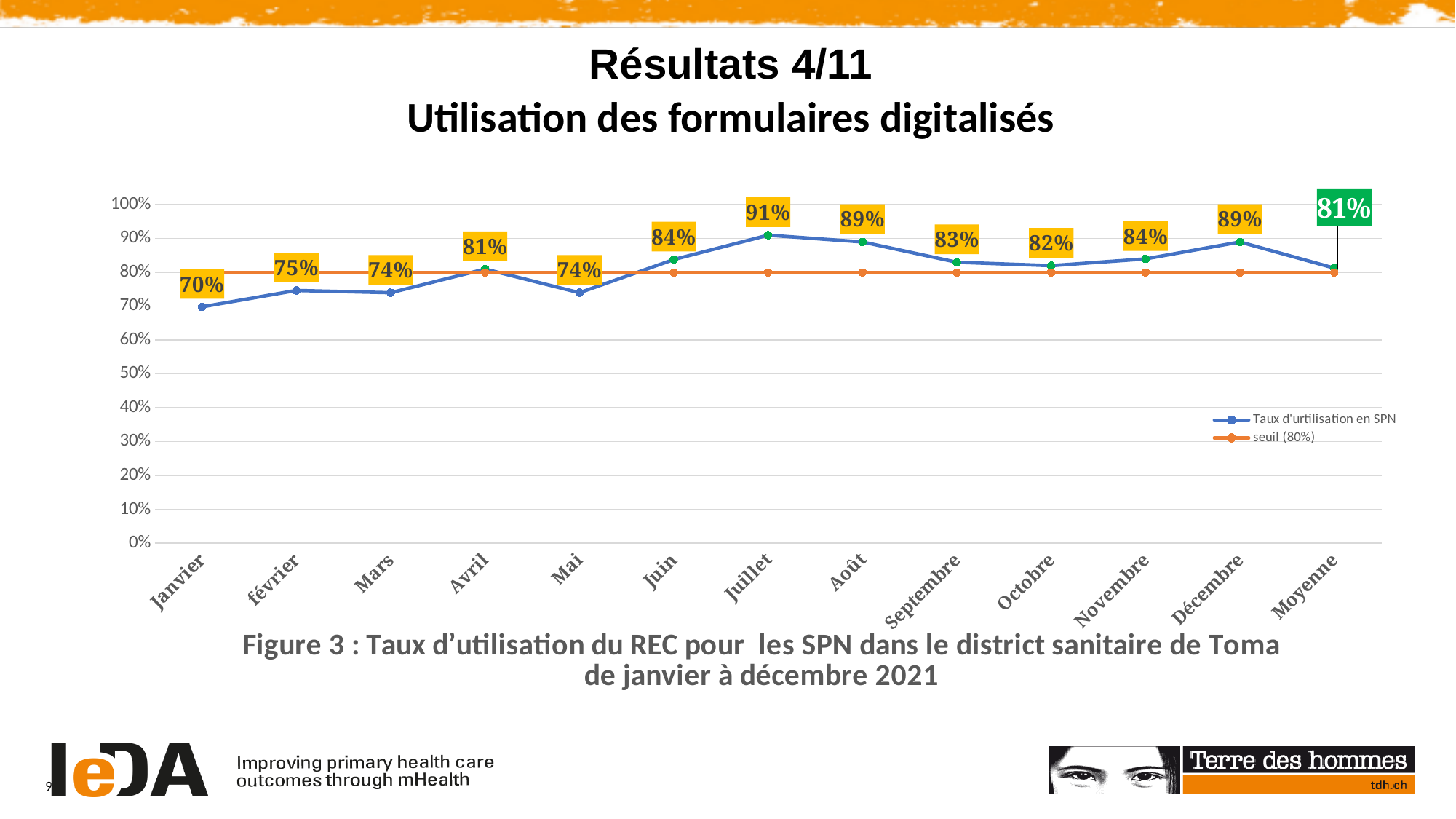
Which month has the highest utilisation rate? Juillet How many categories are shown on the x axis? 13 Which is larger, the utilisation rate in Juin or in Mai? Juin What is the difference between the utilisation rate in Juillet and in Janvier? 21% What kind of chart is shown on the slide? line chart What threshold value does the orange 'seuil' line represent? 80% What is the value for Juillet in the 'Taux d'urtilisation en SPN' series? 91% Is the utilisation rate for Mars greater or less than 80%? less What is the value for Janvier in the 'Taux d'urtilisation en SPN' series? 70% What is the value shown for Moyenne? 81% How many series does the legend list? 2 Which month has the lowest utilisation rate? Janvier